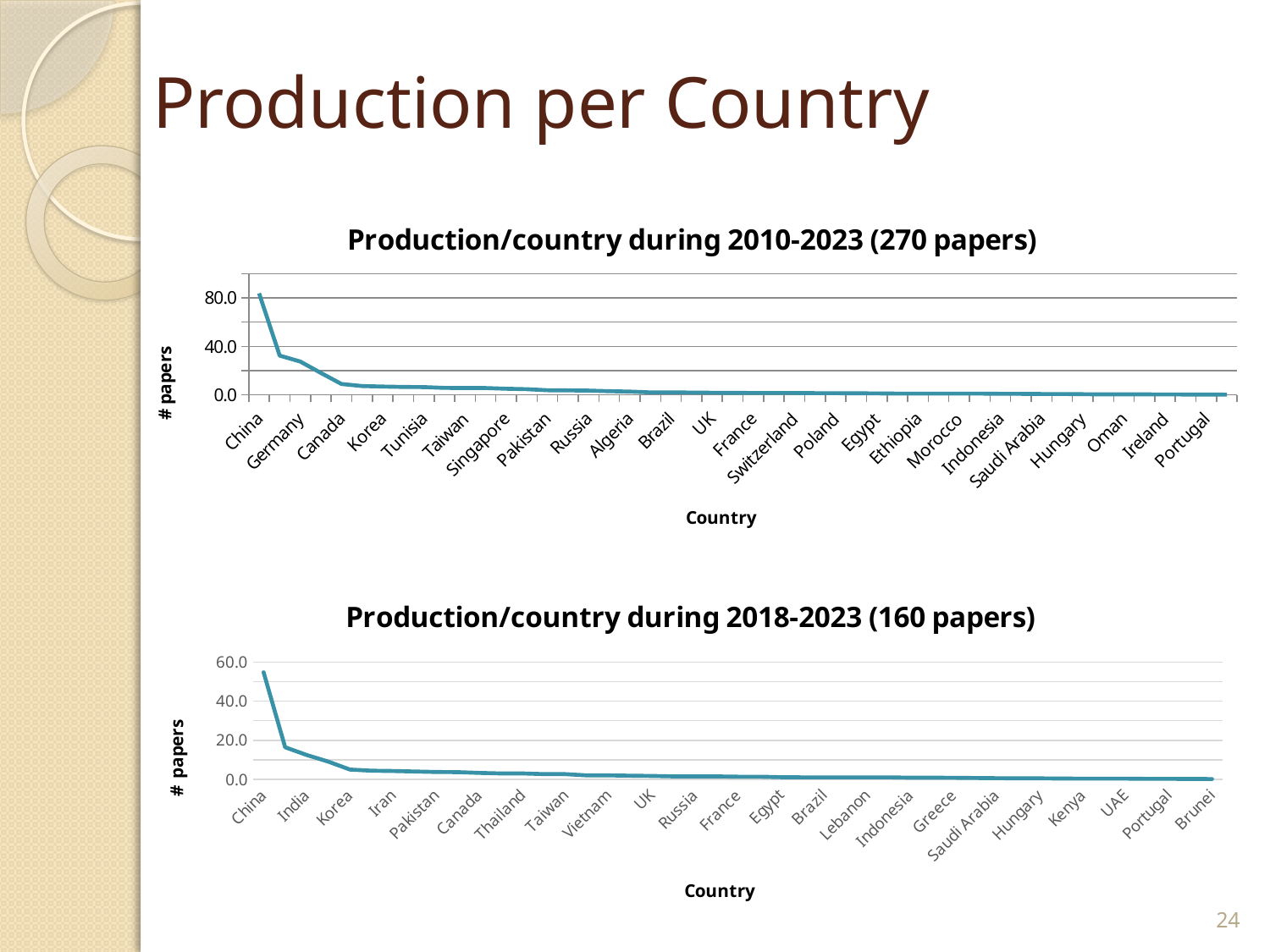
In the top chart (2010-2023), which country has the highest number of papers? China In the bottom chart (2018-2023), which country has the highest number of papers? China In the top chart (2010-2023), which has more papers, Germany or Canada? Germany In the top chart (2010-2023), is the value for China greater or less than 40? greater What is the title of the bottom chart? Production/country during 2018-2023 (160 papers) What kind of chart is the top chart, 'Production/country during 2010-2023 (270 papers)'? line chart In the top chart (2010-2023), do the values rise or fall moving from left to right along the x axis? fall In the bottom chart (2018-2023), is the value for India greater or less than 20? less In the bottom chart (2018-2023), is the value for China greater or less than 40? greater What is the y-axis label of the top chart? # papers In the bottom chart (2018-2023), which has more papers, India or Korea? India